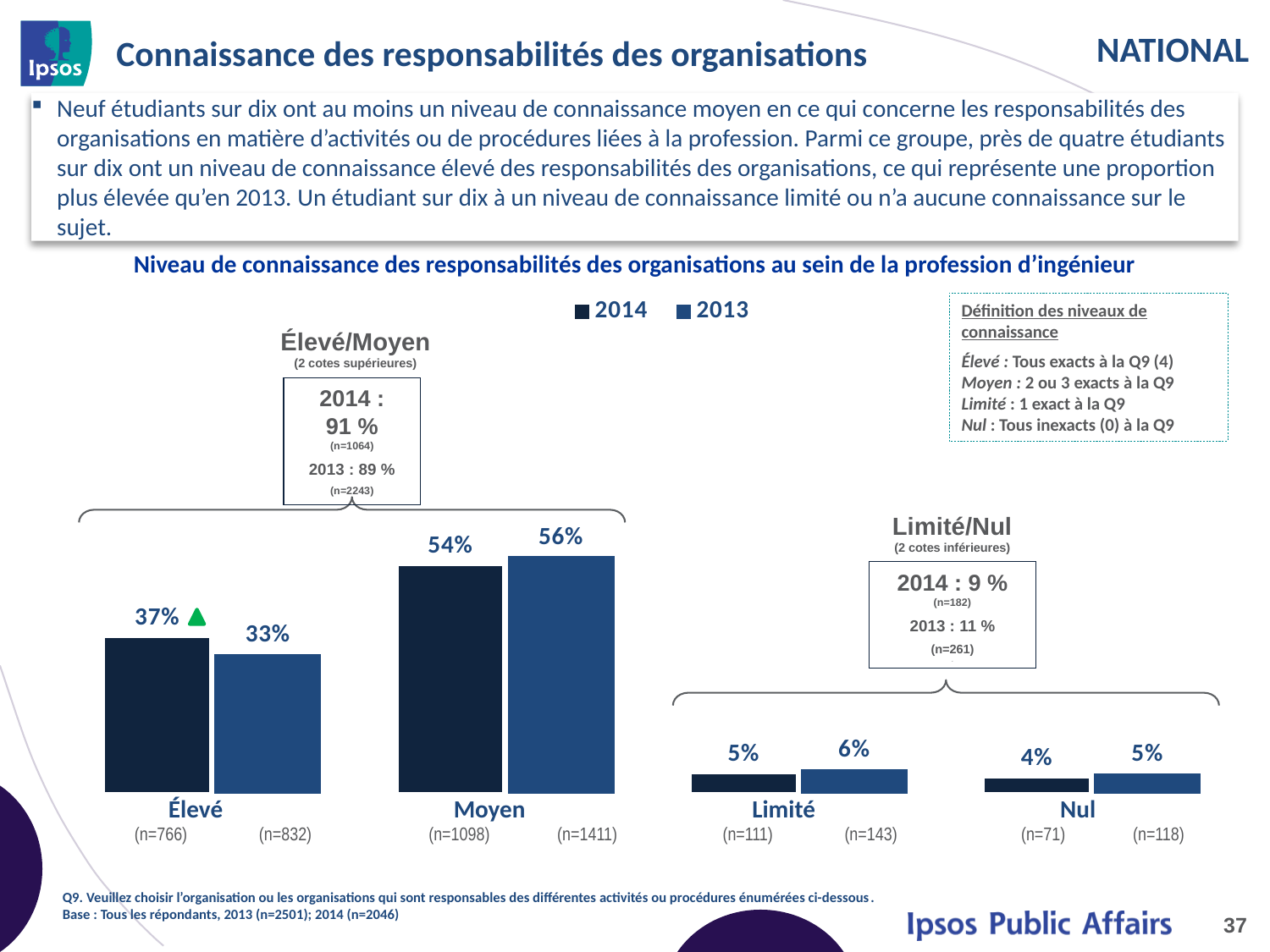
How many series does the legend list? 2 Which category has the lowest 2014 value? Nul How many categories are shown on the x axis? 4 What is the 2014 value for Moyen? 54% Which category has the highest 2014 value? Moyen What are the two series named in the legend? 2014 and 2013 For Moyen, which year has the larger value, 2014 or 2013? 2013 What is the 2013 value for Élevé? 33% What kind of chart is shown on the slide? Bar chart What is the 2013 value for Limité? 6% What is the 2014 value for Nul? 4% What is the difference between the 2014 and 2013 values for Élevé? 4 percentage points